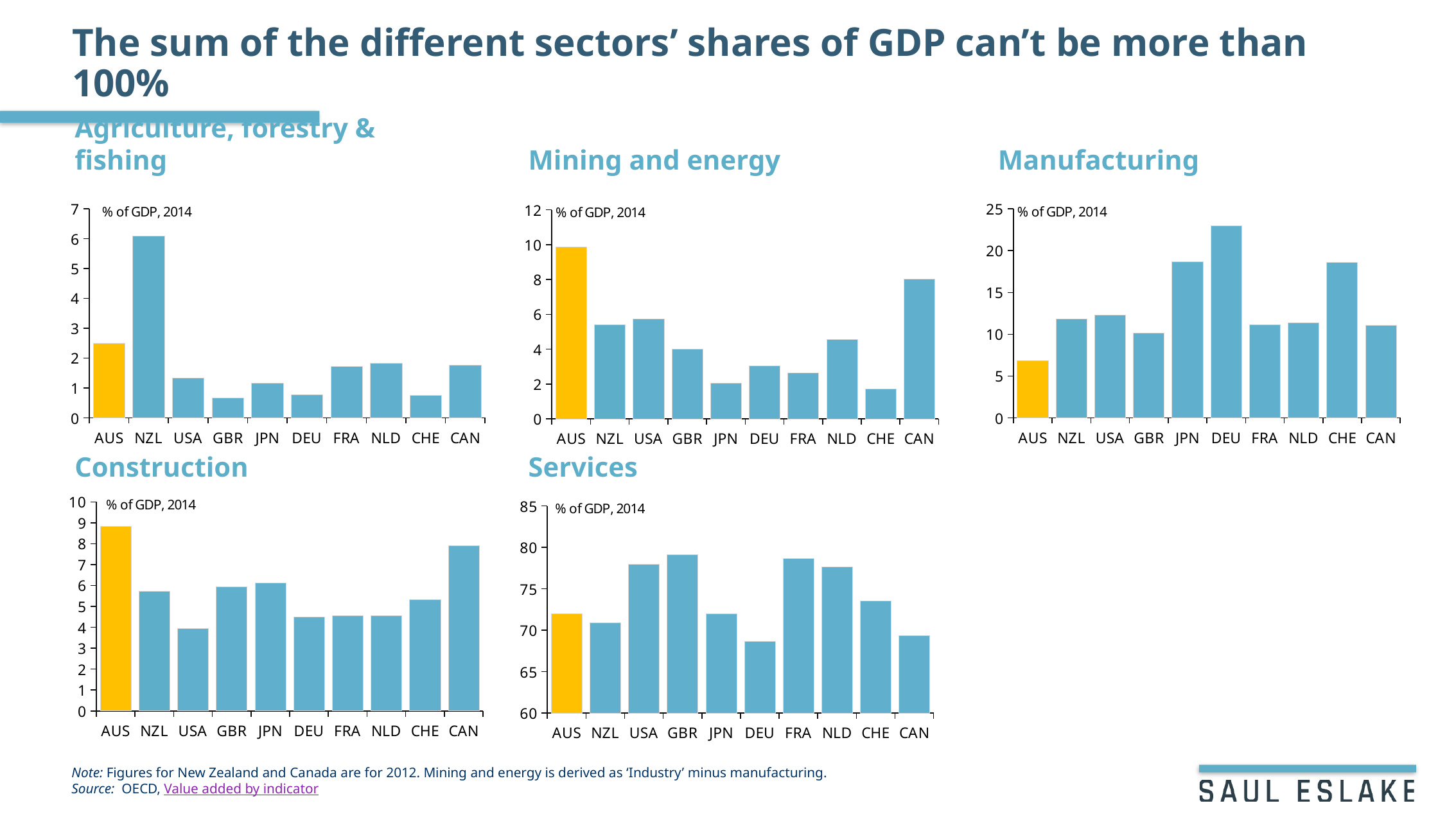
In the Mining and energy chart, which country has the highest share of GDP? AUS In the Manufacturing chart, which is larger, the value for JPN or the value for GBR? JPN In the Construction chart, which country has the lowest share of GDP? USA In the Construction chart, is the value for AUS greater or less than 8? greater In the Mining and energy chart, is the value for CAN greater or less than 6? greater What kind of chart is the Construction chart? Bar chart In the Agriculture, forestry & fishing chart, which country has the highest share of GDP? NZL How many countries are shown in the Services chart? 10 How many charts are shown on the slide? 5 In the Manufacturing chart, which country has the lowest share of GDP? AUS In the Services chart, is the value for DEU greater or less than 70? less In the Manufacturing chart, which country has the highest share of GDP? DEU